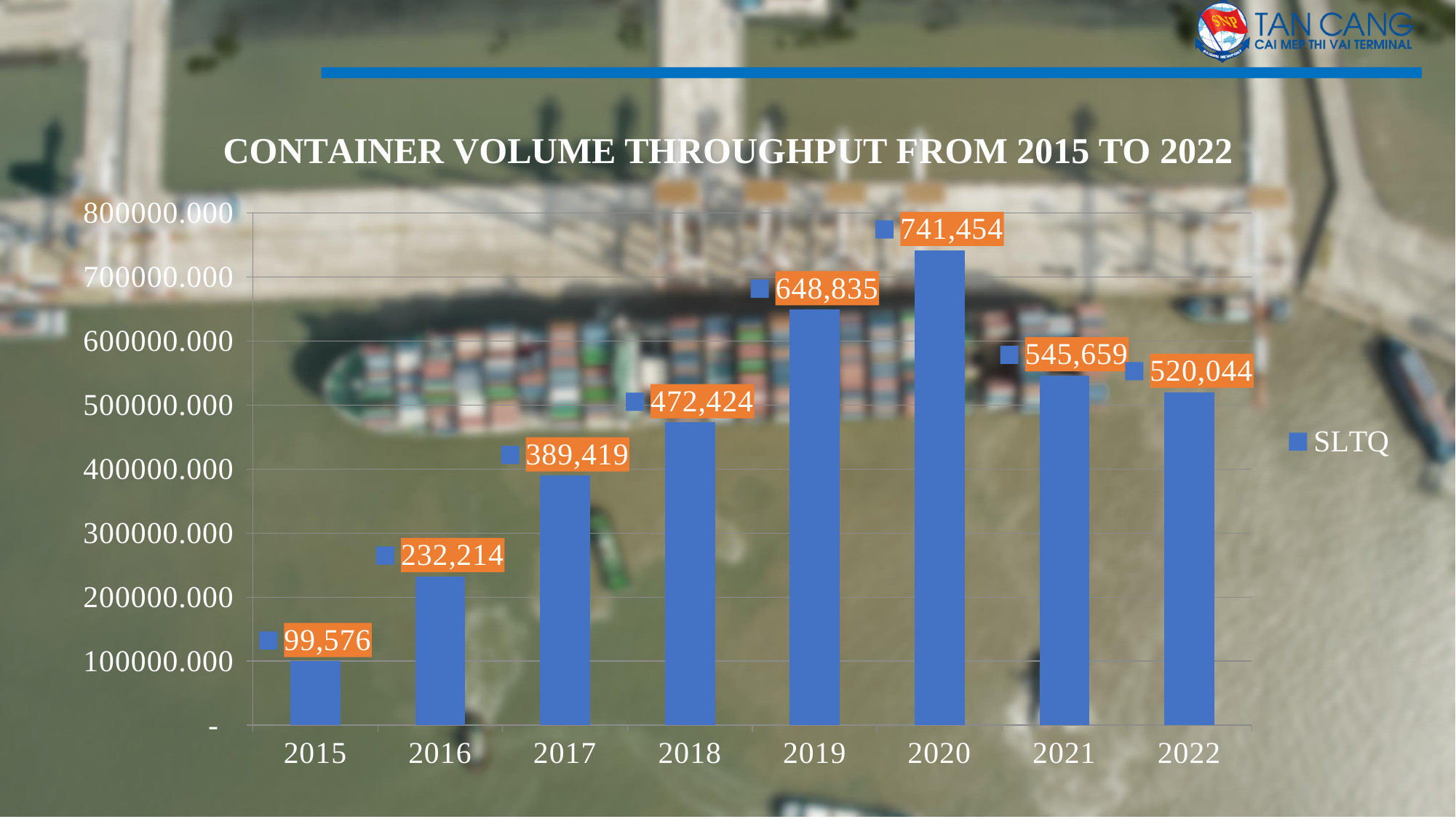
What is the value shown for 2015? 99,576 What is the value shown for 2018? 472,424 How many years are shown on the x axis of the chart? 8 How many series does the legend list? 1 Do the values rise or fall from 2015 to 2020? Rise What kind of chart is shown on the slide? Bar chart What is the difference between the values for 2021 and 2022? 25,615 What is the container volume throughput value shown for 2020? 741,454 What is the difference between the values for 2020 and 2019? 92,619 Which year has the lowest container volume throughput? 2015 Which year has the highest container volume throughput? 2020 Which year has the larger value, 2017 or 2018? 2018